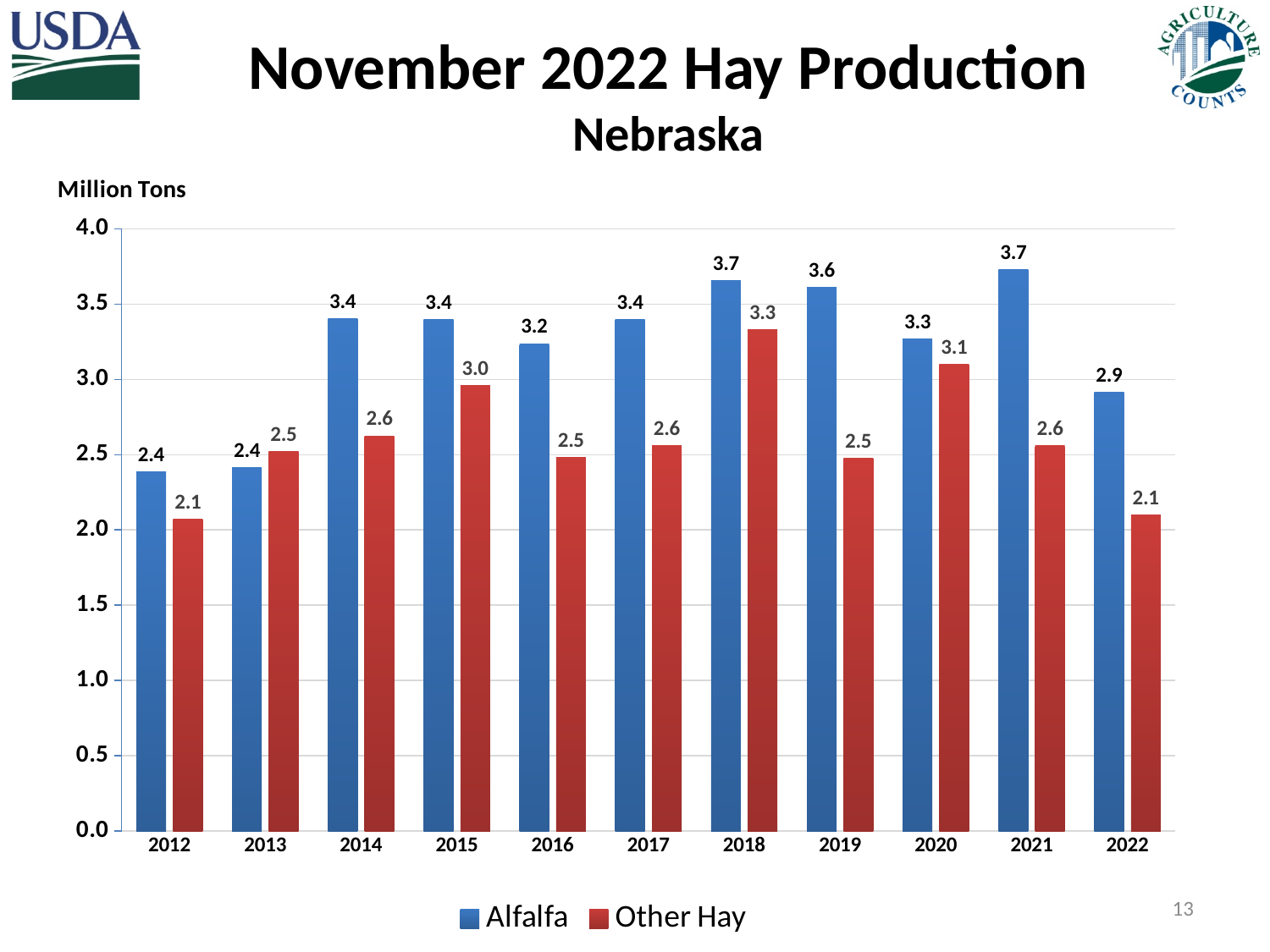
What is the Alfalfa production value for 2018? 3.7 In which year is Other Hay production highest? 2018 What is the Other Hay production value for 2020? 3.1 What is the Alfalfa production value for 2022? 2.9 Does Other Hay production rise or fall from 2012 to 2015? rise How many series does the legend list? 2 What unit is shown for the y axis? Million Tons What kind of chart is shown on the slide? bar chart How many years are shown on the x axis? 11 Is the Alfalfa value for 2022 greater or less than 3.0? less In 2013, which is larger: Alfalfa or Other Hay production? Other Hay What is the difference between Alfalfa and Other Hay production in 2022? 0.8